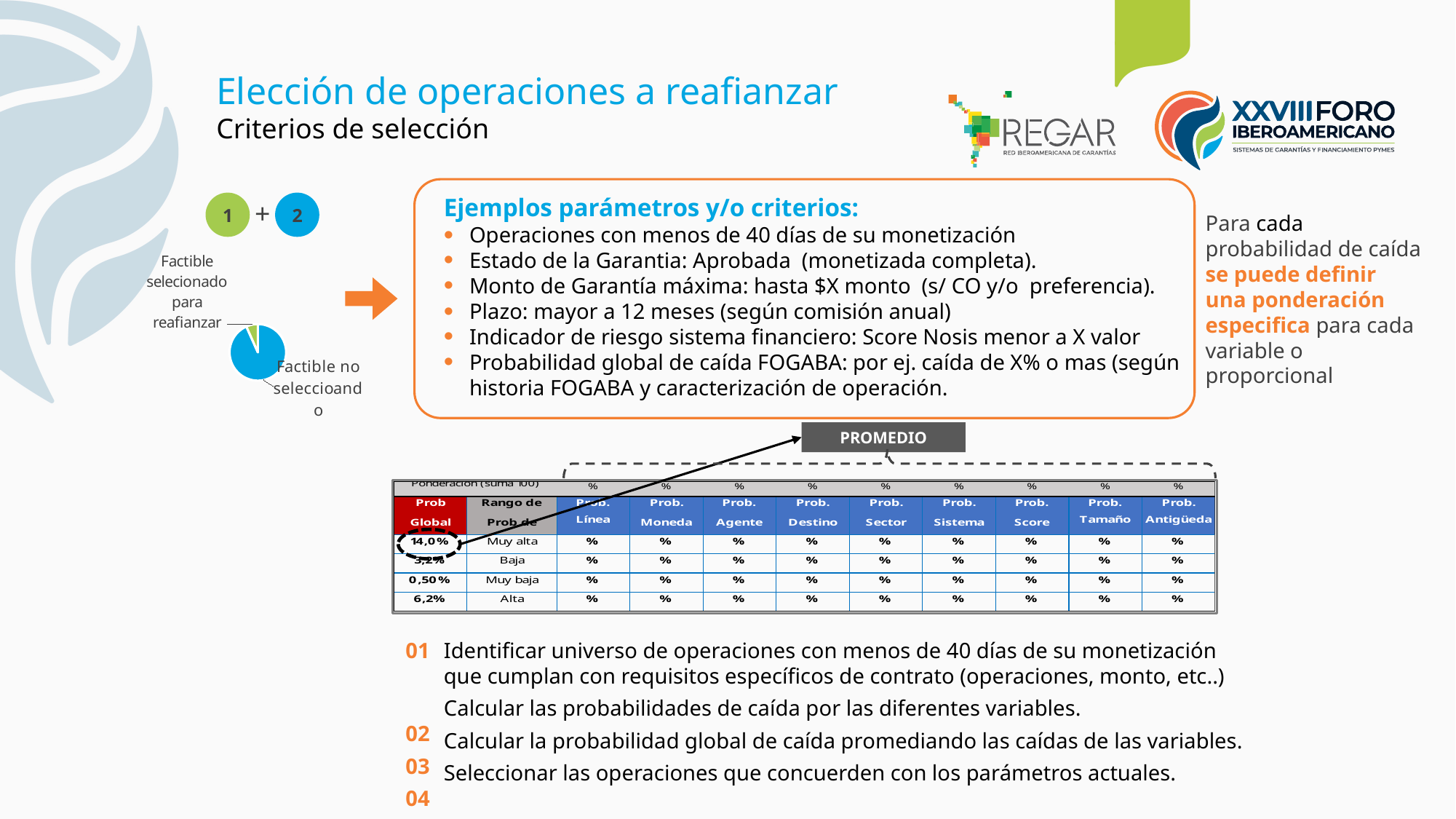
Which slice of the pie chart is the smallest? Factible selecionado para reafianzar Which slice of the pie chart is the largest? Factible no seleccioando How many slices does the pie chart have? 2 What kind of chart is shown on the left of the slide? pie chart What colour is the 'Factible seleccionado para reafianzar' slice in the pie chart? green What colour is the 'Factible no seleccioando' slice in the pie chart? blue In the pie chart, which is larger: the slice for 'Factible seleccionado para reafianzar' or the slice for 'Factible no seleccioando'? Factible no seleccioando